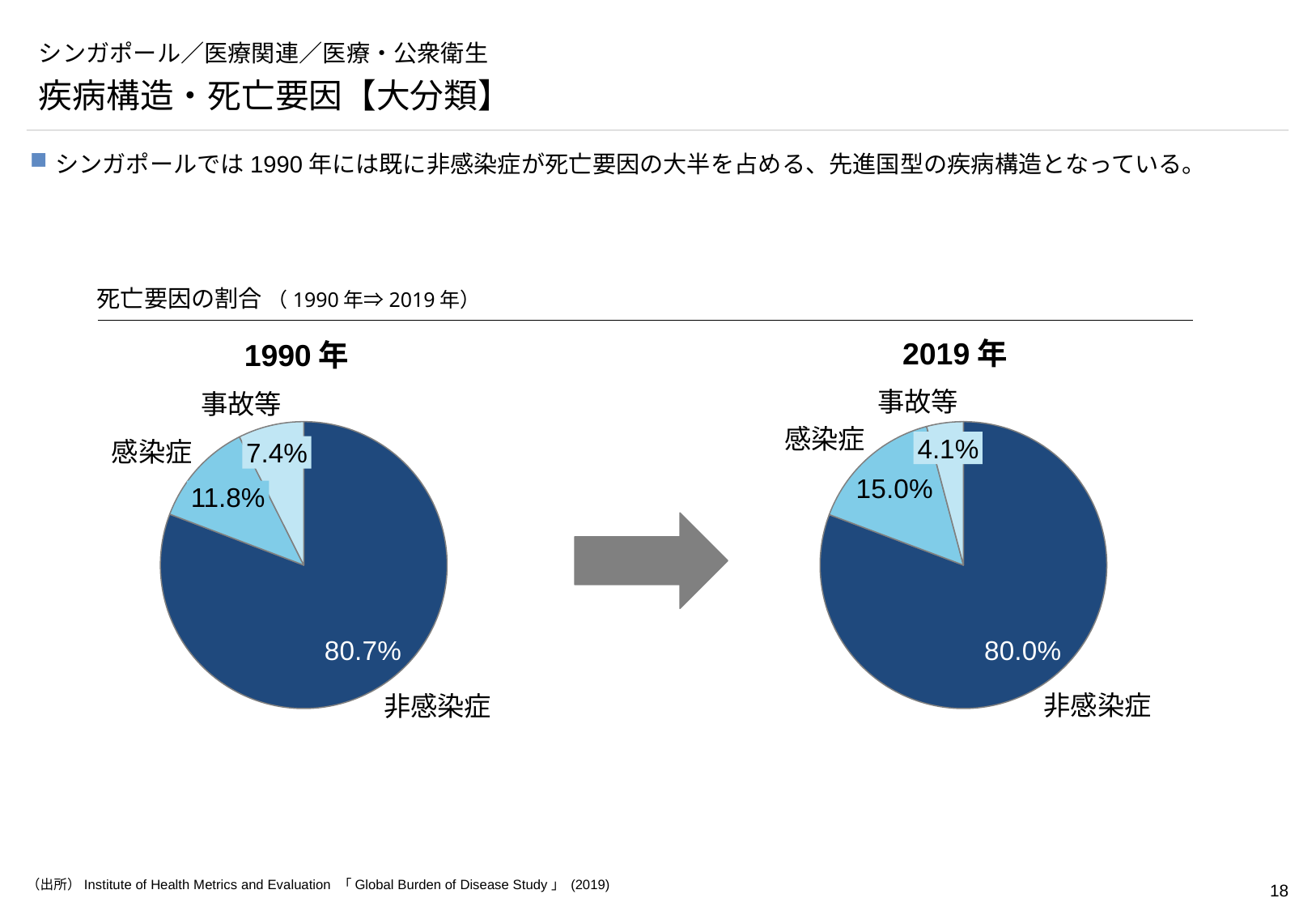
In the 2019年 pie chart, which category has the smallest share? 事故等 What kind of chart is the 2019年 chart? pie chart In the 1990年 pie chart, what share is 事故等? 7.4% How many categories does the 1990年 pie chart show? 3 In the 1990年 pie chart, which category has the largest share? 非感染症 In the 1990年 pie chart, what share is 感染症? 11.8% In the 2019年 pie chart, what share is 事故等? 4.1% Which is larger: the share of 感染症 in the 1990年 pie chart or in the 2019年 pie chart? 2019年 In the 2019年 pie chart, what share is 非感染症? 80.0% In the 2019年 pie chart, what share is 感染症? 15.0% In the 2019年 pie chart, what is the difference between the shares of 感染症 and 事故等? 10.9% In the 1990年 pie chart, what share is 非感染症? 80.7%